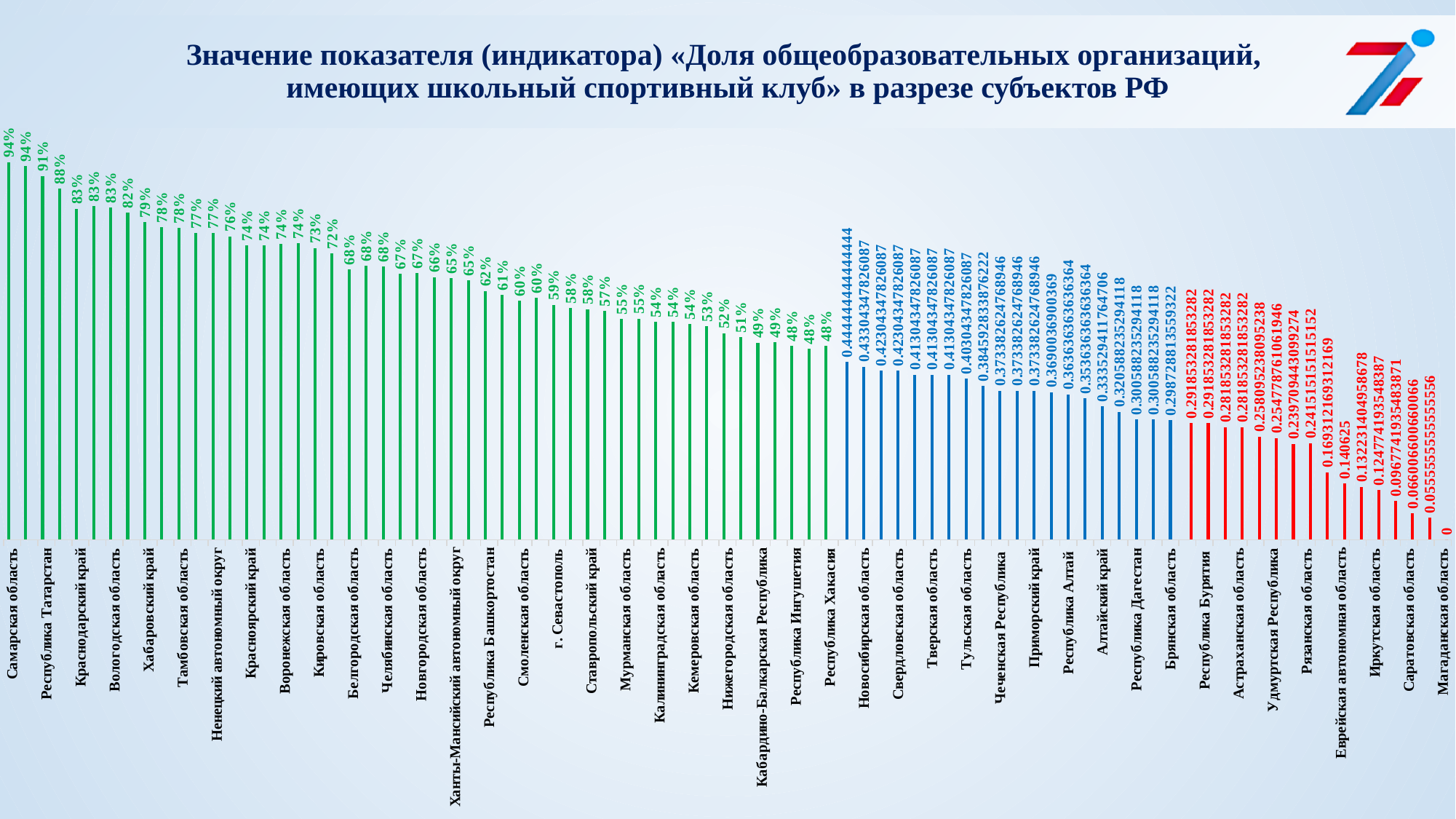
What is the highest value shown on the chart? 94% What is the value shown for Самарская область? 94% What is the value shown for Магаданская область? 0 Which has the larger value, Самарская область or Магаданская область? Самарская область Do the values rise or fall from left to right along the x axis? fall What colour are the bars on the left side of the chart with the highest values? green Which region has the lowest value on the chart? Магаданская область What kind of chart is shown on the slide? bar chart How many different bar colours are used in the chart? 3